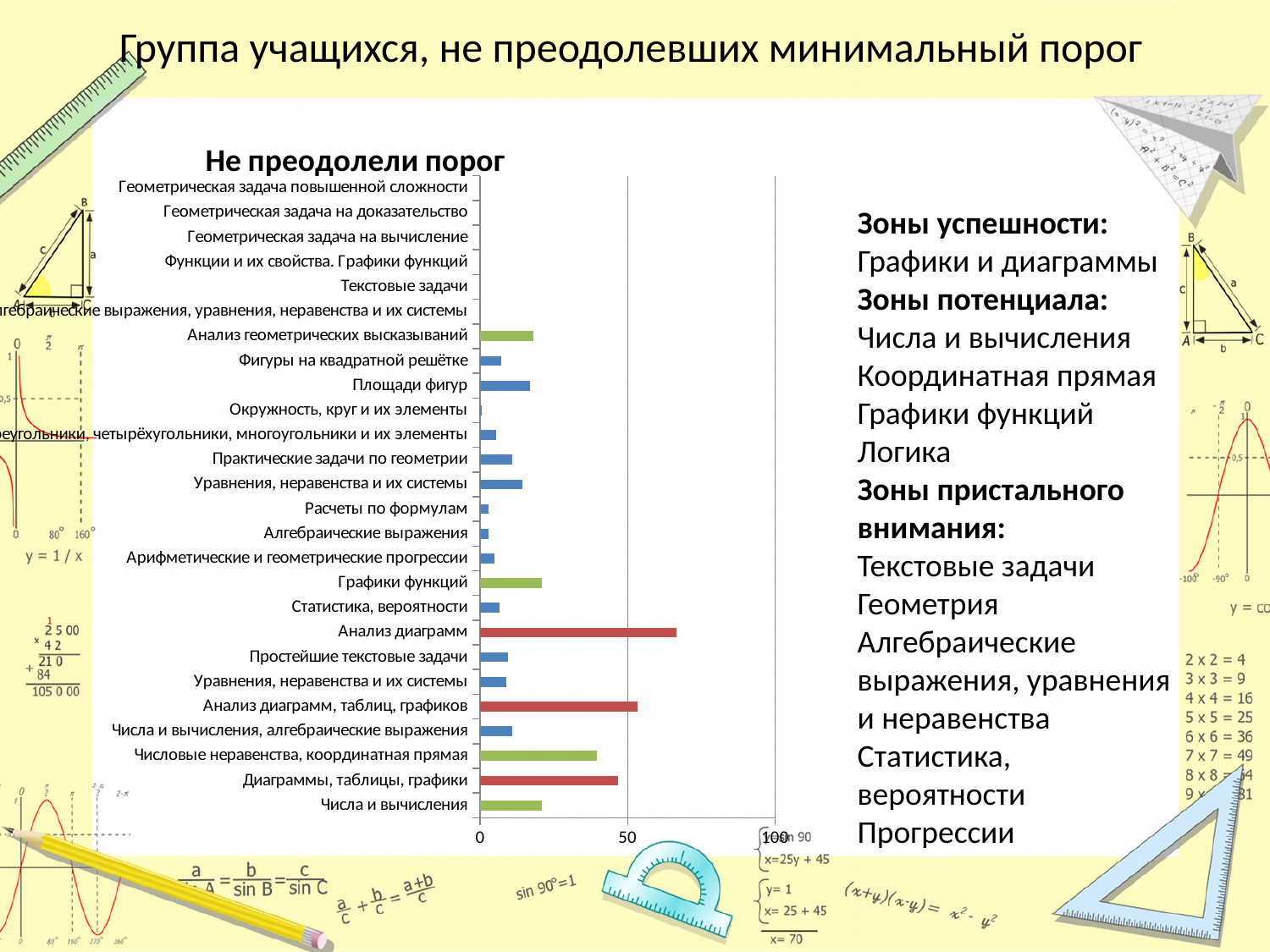
What kind of chart is shown on the slide? bar chart Is the value for Числовые неравенства, координатная прямая greater or less than 50? less Which is larger, the value for Анализ диаграмм or the value for Числа и вычисления? Анализ диаграмм Which is larger, the value for Числовые неравенства, координатная прямая or the value for Площади фигур? Числовые неравенства, координатная прямая Is the value for Графики функций greater or less than 50? less What is the title of the chart? Не преодолели порог Is the value for Анализ диаграмм greater or less than 50? greater How many categories are listed on the chart's vertical axis? 26 How many bars in the chart are coloured red? 3 Which category has the highest value in the chart? Анализ диаграмм Which is larger, the value for Диаграммы, таблицы, графики or the value for Статистика, вероятности? Диаграммы, таблицы, графики